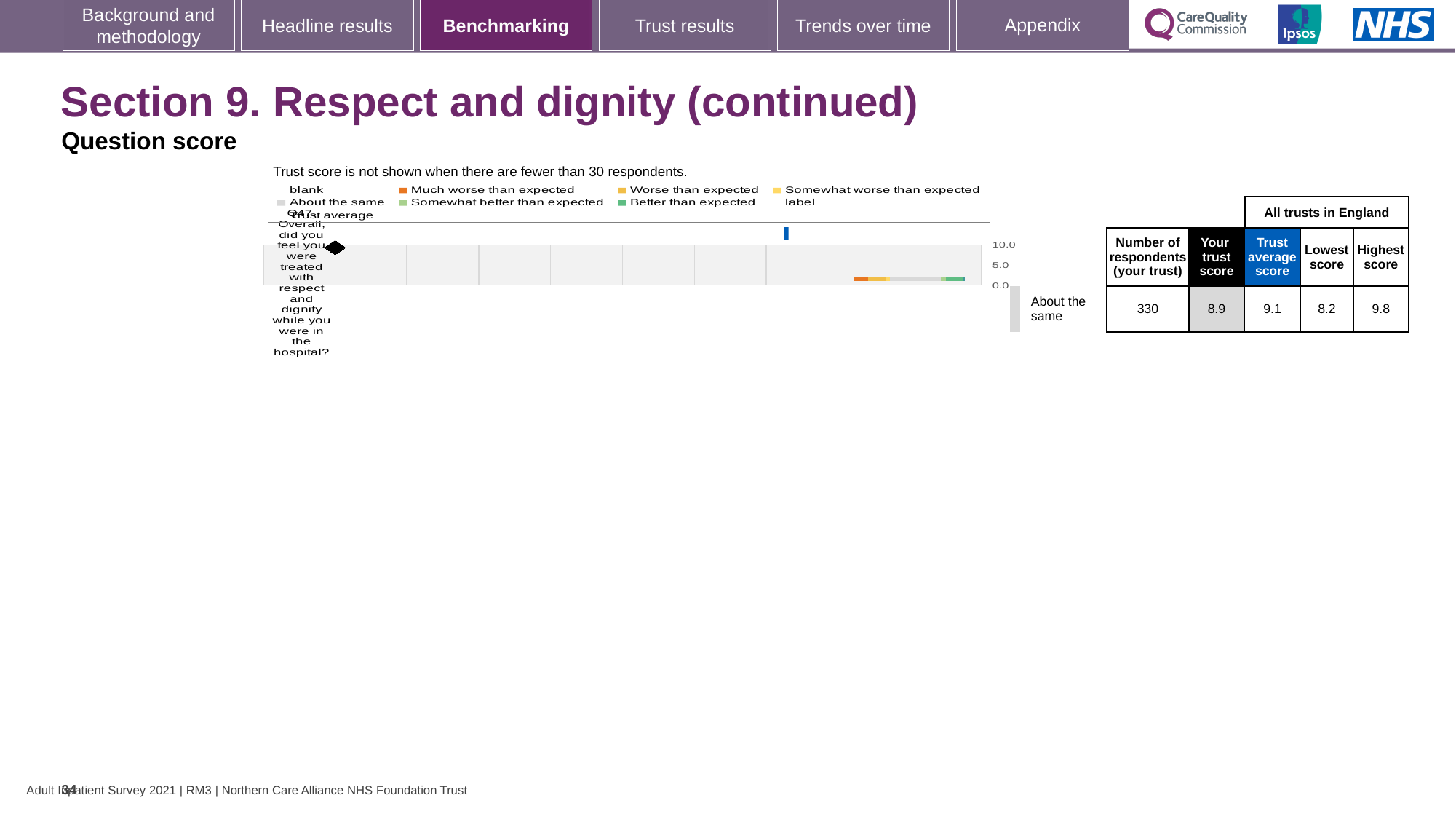
What is the 'Highest score' across all trusts in England for Q47? 9.8 How many respondents from your trust answered Q47? 330 What is the difference between the 'Highest score' and the 'Lowest score' for Q47? 1.6 Which is larger for Q47: 'Your trust score' or the 'Trust average score'? Trust average score What is the 'Lowest score' across all trusts in England for Q47? 8.2 What is 'Your trust score' for Q47? 8.9 How many questions are plotted on the chart? 1 What is the highest tick value shown on the chart's score axis? 10.0 Which question number is plotted on the chart? Q47 What is the 'Trust average score' for Q47? 9.1 What kind of chart is shown on the slide? bar chart What benchmark category is shown for Q47 on the chart? About the same